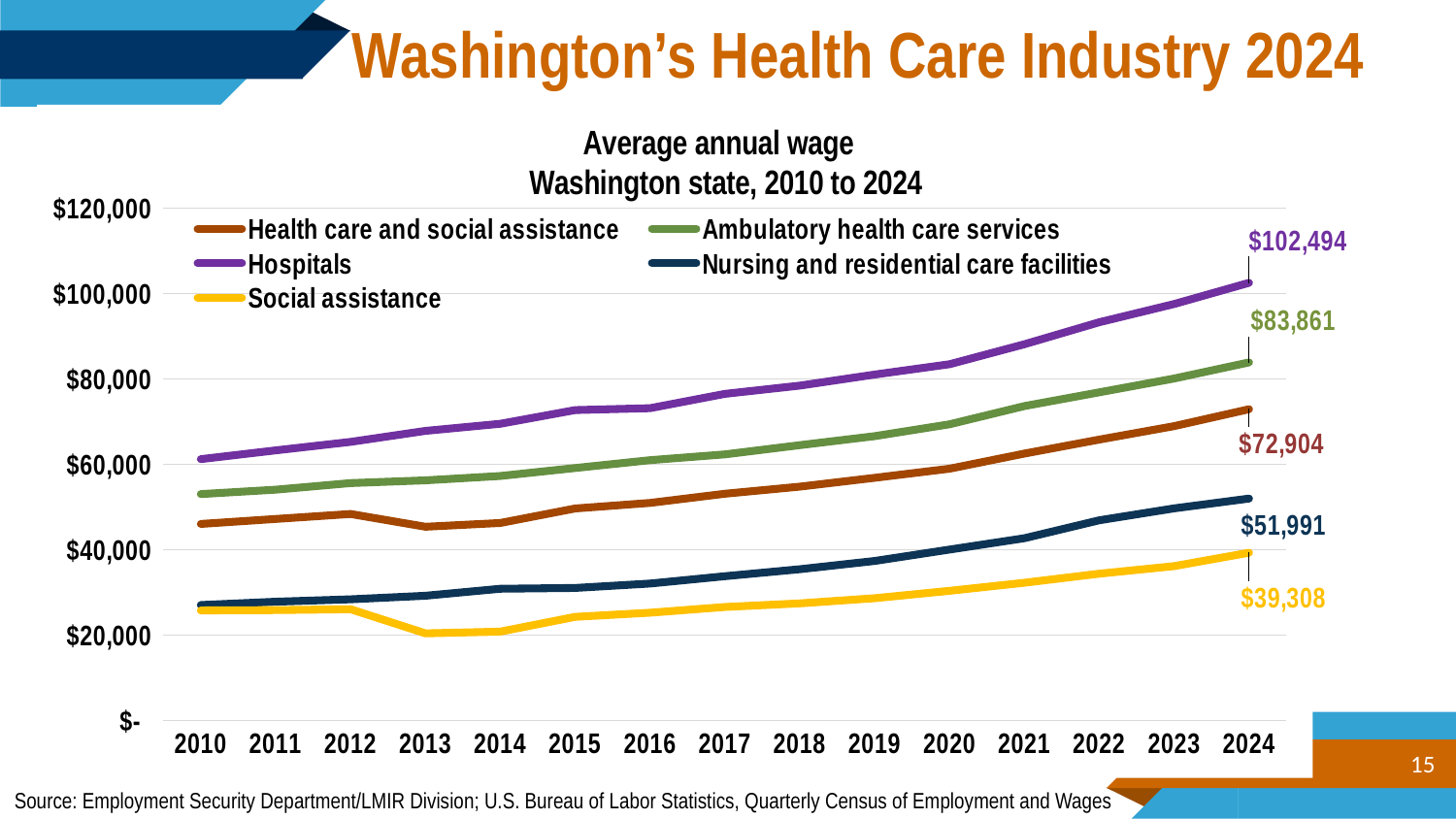
Which series has the highest average annual wage in 2024? Hospitals What is the 2024 average annual wage for Nursing and residential care facilities? $51,991 Which is larger in 2024: the wage for Health care and social assistance or for Nursing and residential care facilities? Health care and social assistance What is the 2024 average annual wage for Social assistance? $39,308 Which series has the lowest average annual wage in 2024? Social assistance What is the difference between the 2024 wages for Hospitals and Ambulatory health care services? $18,633 What kind of chart is shown on the slide? Line chart How many years are shown on the x axis? 15 What is the 2024 average annual wage for Hospitals? $102,494 Is the 2013 average annual wage for Social assistance greater or less than $40,000? less How many series does the legend list? 5